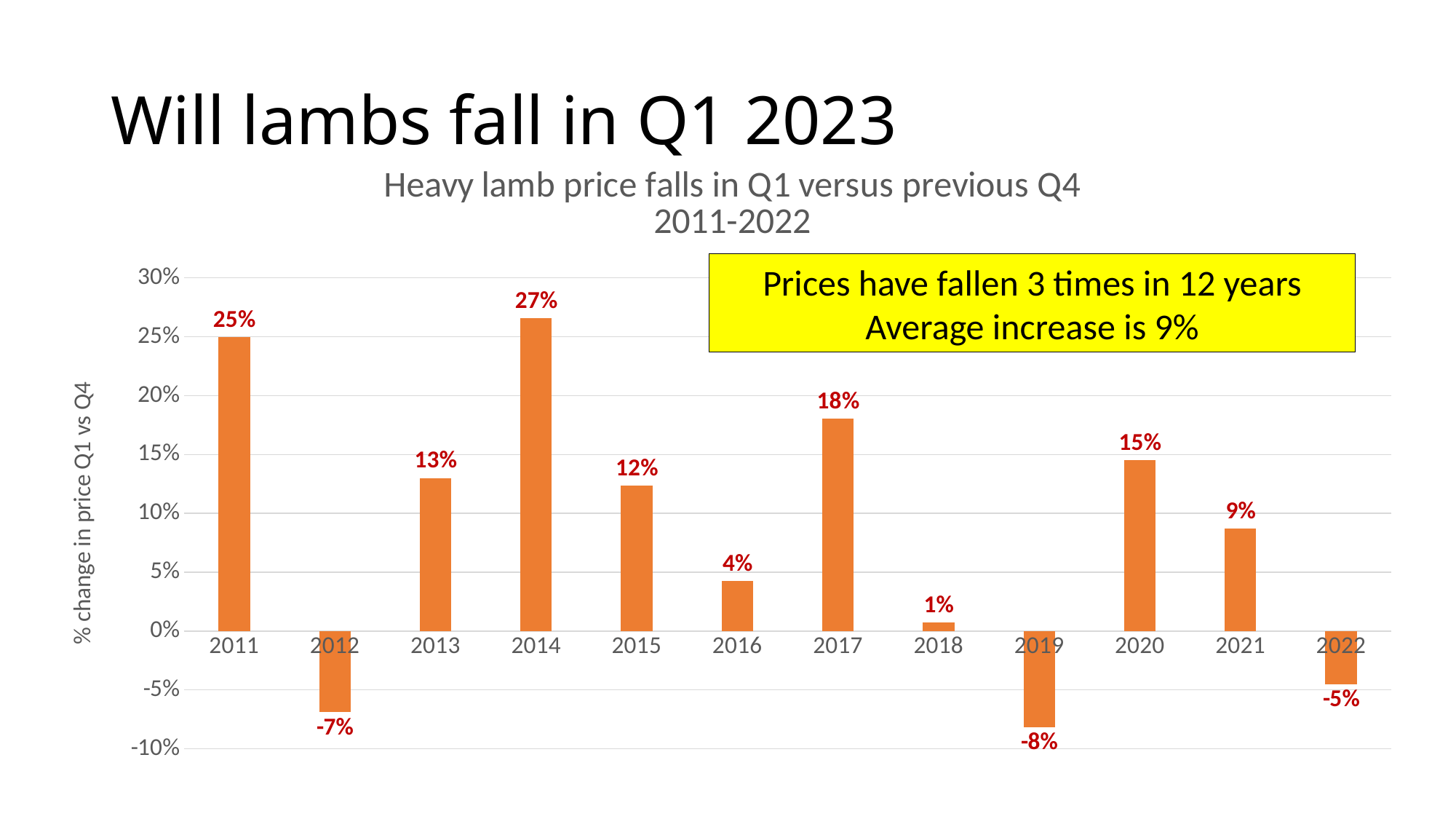
What is the value for 2022? -5% Which year has the highest value? 2014 What kind of chart is this? bar chart What is the value for 2014? 27% What is the title of the chart? Heavy lamb price falls in Q1 versus previous Q4 2011-2022 What is the value for 2019? -8% Which year has the lowest value? 2019 Which is larger, the value for 2017 or the value for 2020? 2017 What is the difference between the values for 2011 and 2013? 12% How many years are shown on the x axis? 12 Is the value for 2021 greater or less than 10%? less How many years show a negative value? 3